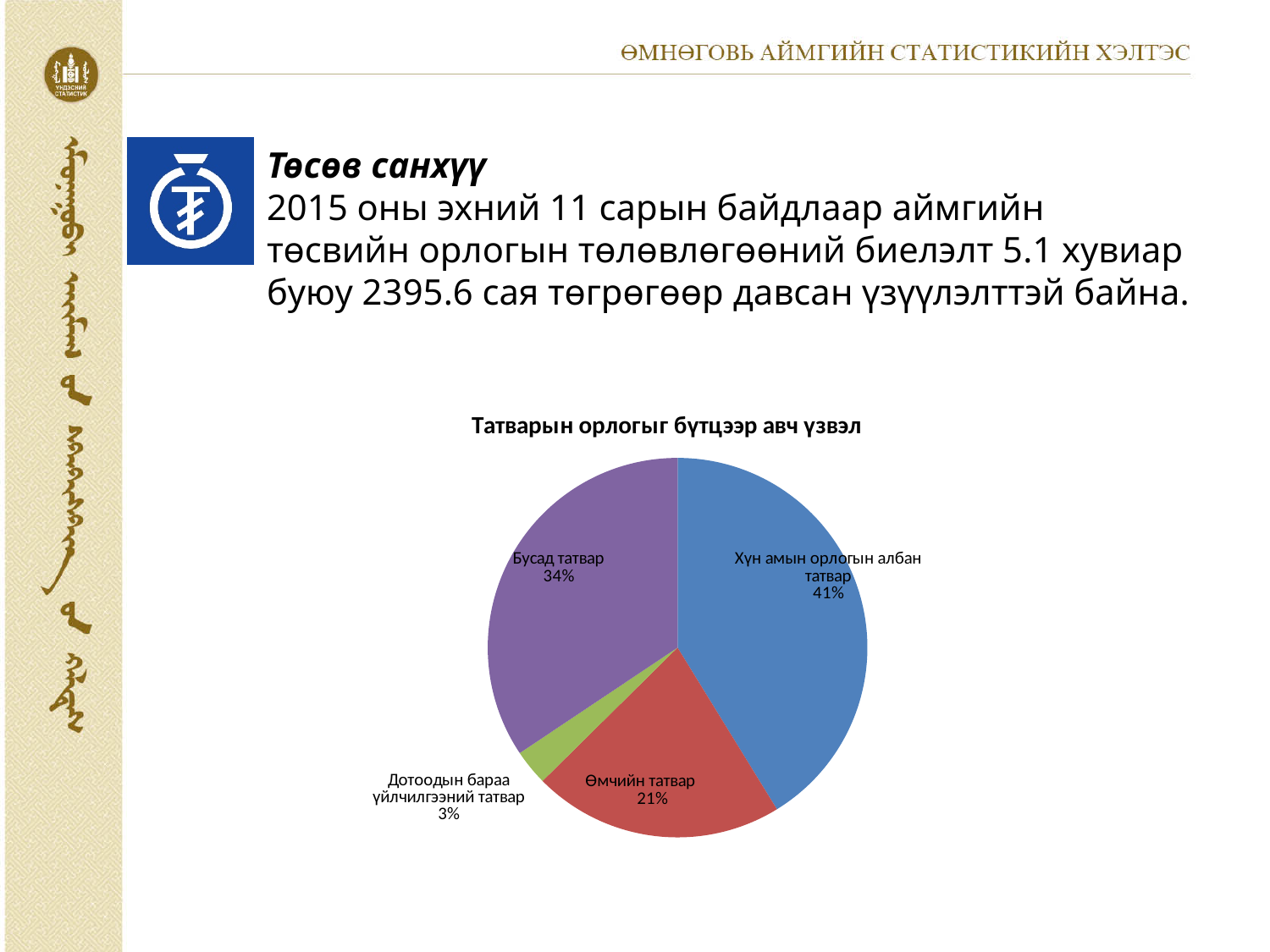
Which is larger, the share for Бусад татвар or the share for Өмчийн татвар? Бусад татвар Which category has the smallest share of the pie? Дотоодын бараа үйлчилгээний татвар What is the difference in percentage points between Хүн амын орлогын албан татвар and Өмчийн татвар? 20 How many slices does the pie chart have? 4 Which category has the largest share of the pie? Хүн амын орлогын албан татвар What share of the pie is Бусад татвар? 34% What share of the pie is Өмчийн татвар? 21% What kind of chart is shown on the slide? pie chart What share of the pie is Дотоодын бараа үйлчилгээний татвар? 3% What is the title of the chart? Татварын орлогыг бүтцээр авч үзвэл What colour is the slice for Өмчийн татвар? red